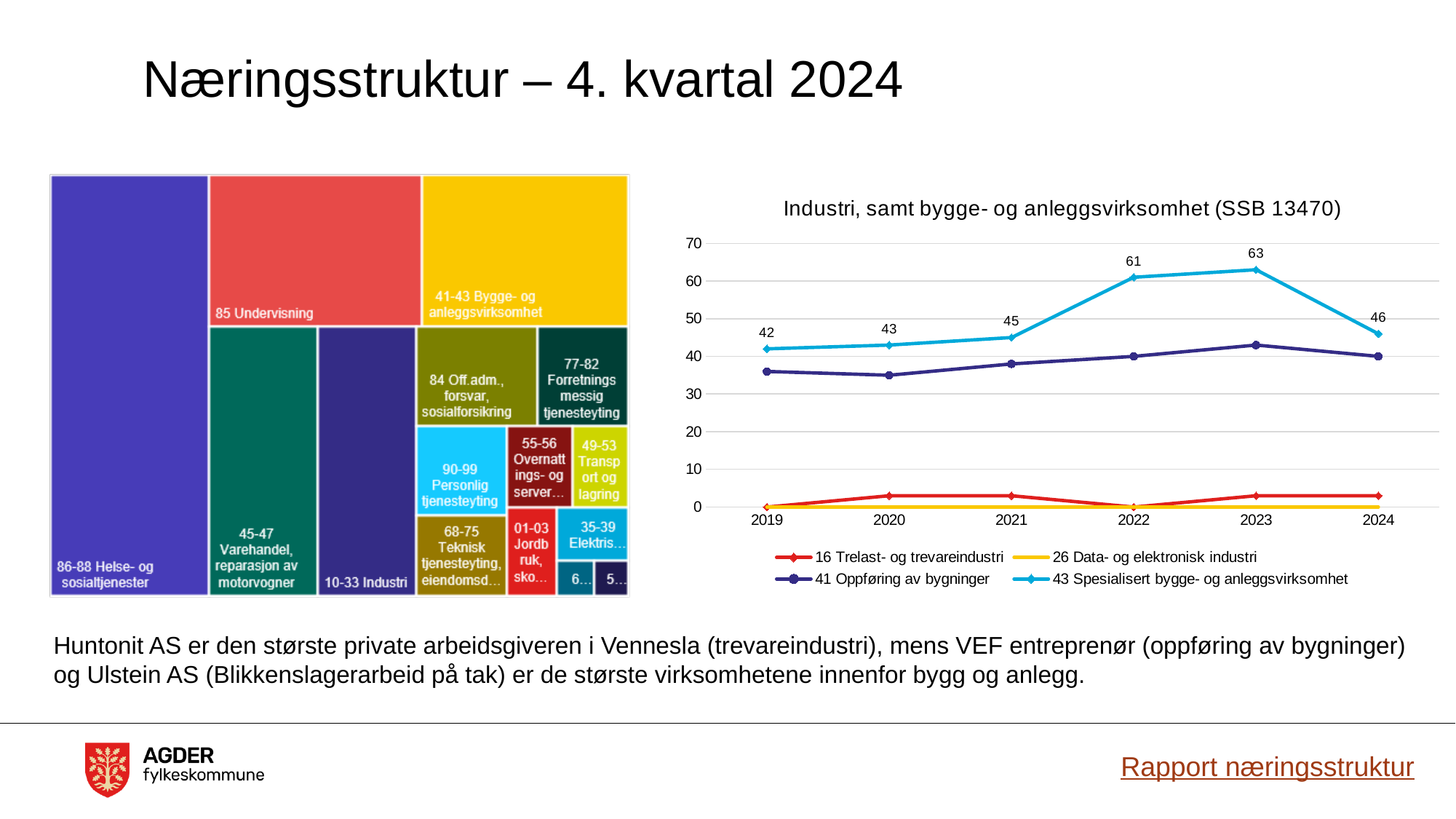
In the line chart titled "Industri, samt bygge- og anleggsvirksomhet (SSB 13470)", is the value for 41 Oppføring av bygninger in 2023 greater or less than 40? greater In the line chart titled "Industri, samt bygge- og anleggsvirksomhet (SSB 13470)", what is the value for 43 Spesialisert bygge- og anleggsvirksomhet in 2019? 42 In the line chart titled "Industri, samt bygge- og anleggsvirksomhet (SSB 13470)", in which year does 43 Spesialisert bygge- og anleggsvirksomhet reach its highest value? 2023 In the line chart titled "Industri, samt bygge- og anleggsvirksomhet (SSB 13470)", which series has the higher value in 2022: 41 Oppføring av bygninger or 43 Spesialisert bygge- og anleggsvirksomhet? 43 Spesialisert bygge- og anleggsvirksomhet In the line chart titled "Industri, samt bygge- og anleggsvirksomhet (SSB 13470)", how many series does the legend list? 4 In the line chart titled "Industri, samt bygge- og anleggsvirksomhet (SSB 13470)", in which year is the value for 43 Spesialisert bygge- og anleggsvirksomhet lowest? 2019 In the line chart titled "Industri, samt bygge- og anleggsvirksomhet (SSB 13470)", how many years are shown on the x axis? 6 In the line chart titled "Industri, samt bygge- og anleggsvirksomhet (SSB 13470)", is the value for 41 Oppføring av bygninger in 2019 greater or less than 40? less In the line chart titled "Industri, samt bygge- og anleggsvirksomhet (SSB 13470)", does the value for 43 Spesialisert bygge- og anleggsvirksomhet rise or fall from 2019 to 2023? rise In the line chart titled "Industri, samt bygge- og anleggsvirksomhet (SSB 13470)", what is the difference between the 2023 and 2024 values for 43 Spesialisert bygge- og anleggsvirksomhet? 17 In the line chart titled "Industri, samt bygge- og anleggsvirksomhet (SSB 13470)", what is the value for 43 Spesialisert bygge- og anleggsvirksomhet in 2022? 61 What kind of chart is the chart on the right side of the slide? line chart